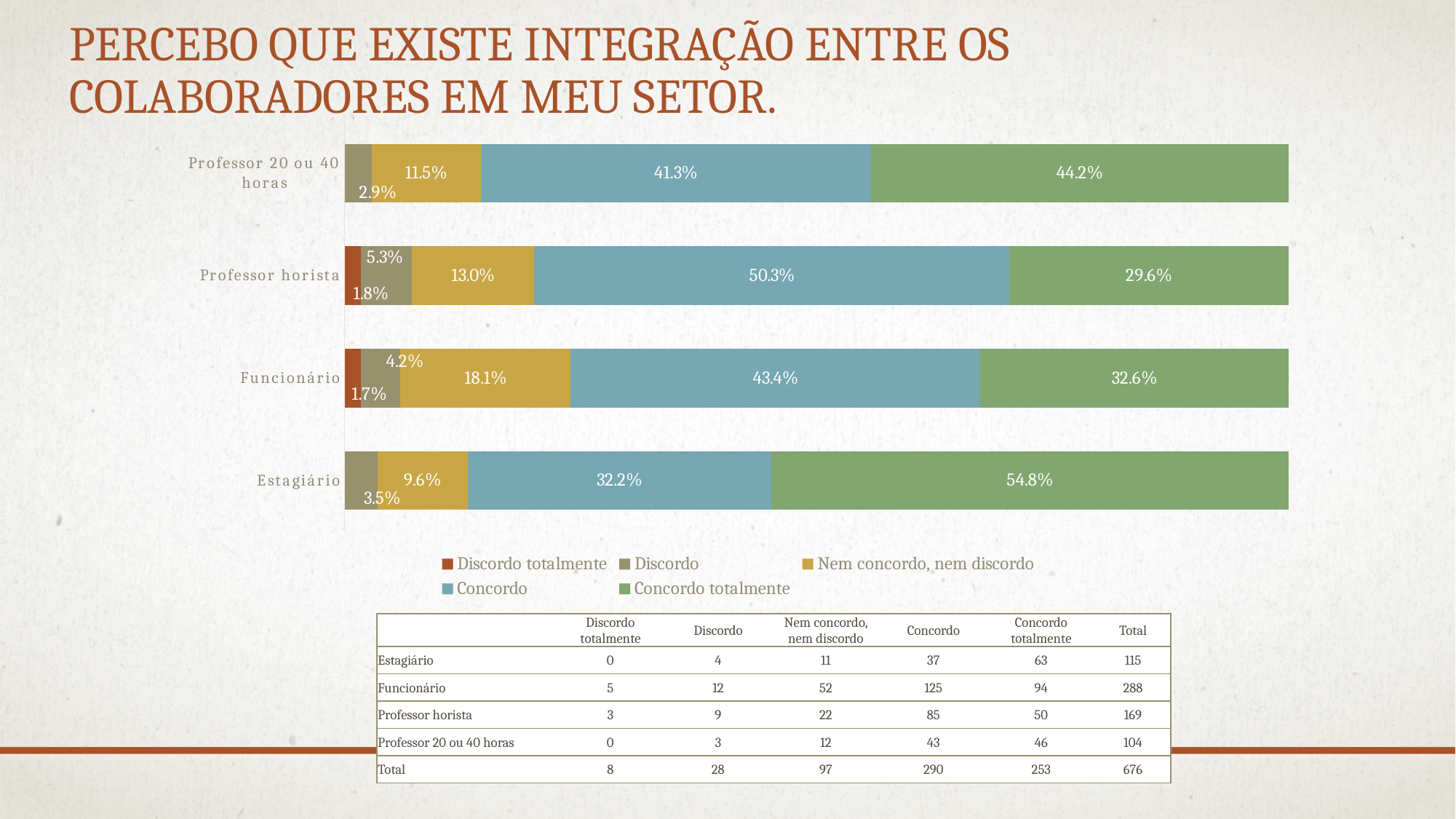
Which is larger: the 'Nem concordo, nem discordo' value for Professor horista or for Estagiário? Professor horista How many categories are plotted on the chart? 4 Which category has the lowest 'Concordo' value? Estagiário Which legend entry is shown in green? Concordo totalmente What is the difference between the 'Concordo totalmente' values for Professor 20 ou 40 horas and Professor horista? 14.6% What kind of chart is shown on the slide? Stacked bar chart What is the 'Nem concordo, nem discordo' value for Funcionário? 18.1% Which category has the highest 'Concordo totalmente' value? Estagiário What is the 'Concordo' value for Professor horista? 50.3% How many series does the chart legend list? 5 What is the 'Discordo' value for Professor 20 ou 40 horas? 2.9% What is the 'Concordo totalmente' value for Estagiário? 54.8%